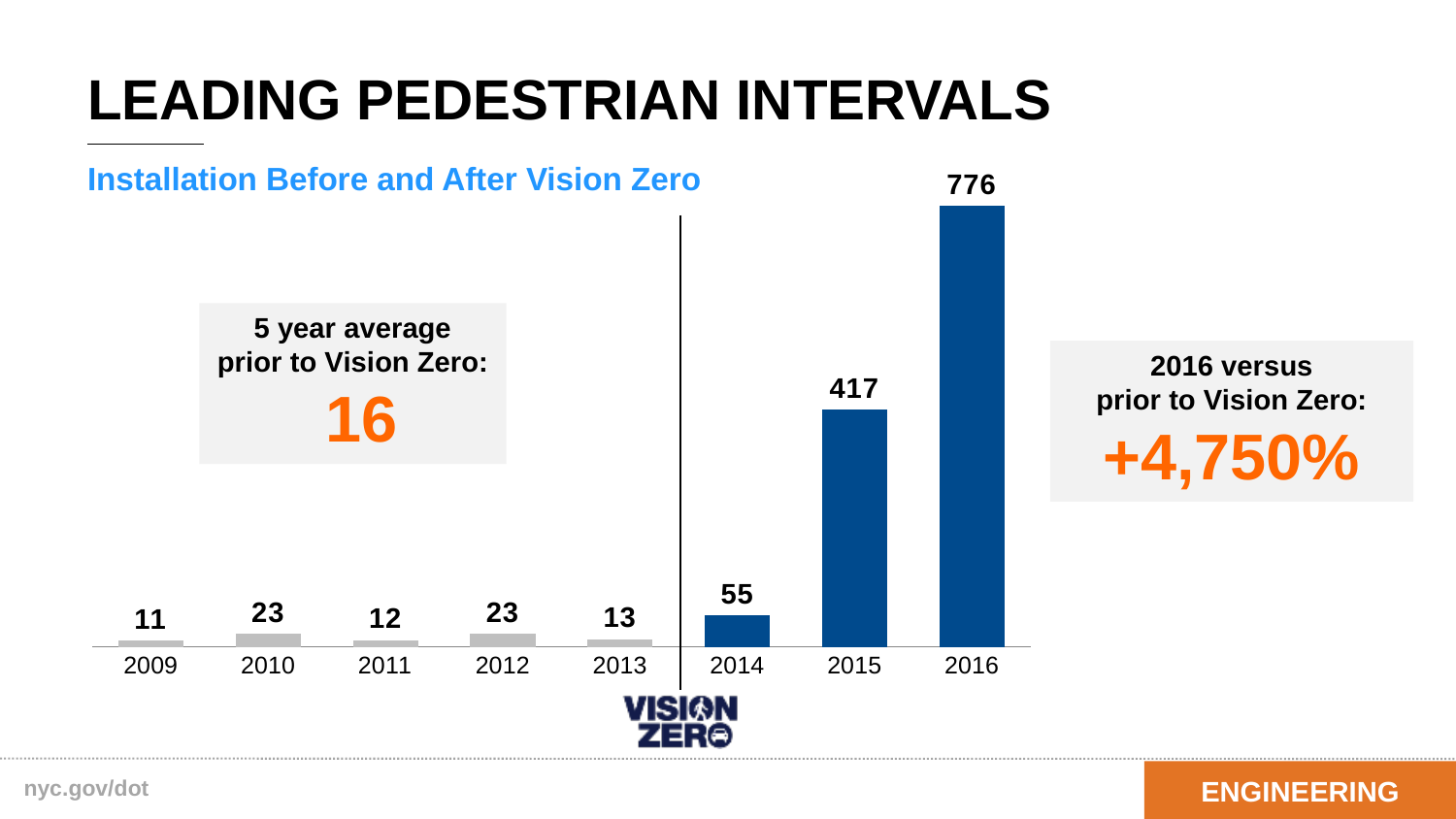
What is the difference between the values for 2014 and 2013? 42 What kind of chart is this? bar chart What percentage change is shown for 2016 versus prior to Vision Zero? +4,750% Which year has the highest value? 2016 What is the value for 2011? 12 What is the difference between the values for 2016 and 2015? 359 Which is larger, the value for 2010 or the value for 2013? 2010 What is the value for 2016? 776 What is the 5 year average prior to Vision Zero shown on the slide? 16 Which year has the lowest value? 2009 What is the value for 2014? 55 How many years are shown on the x axis? 8